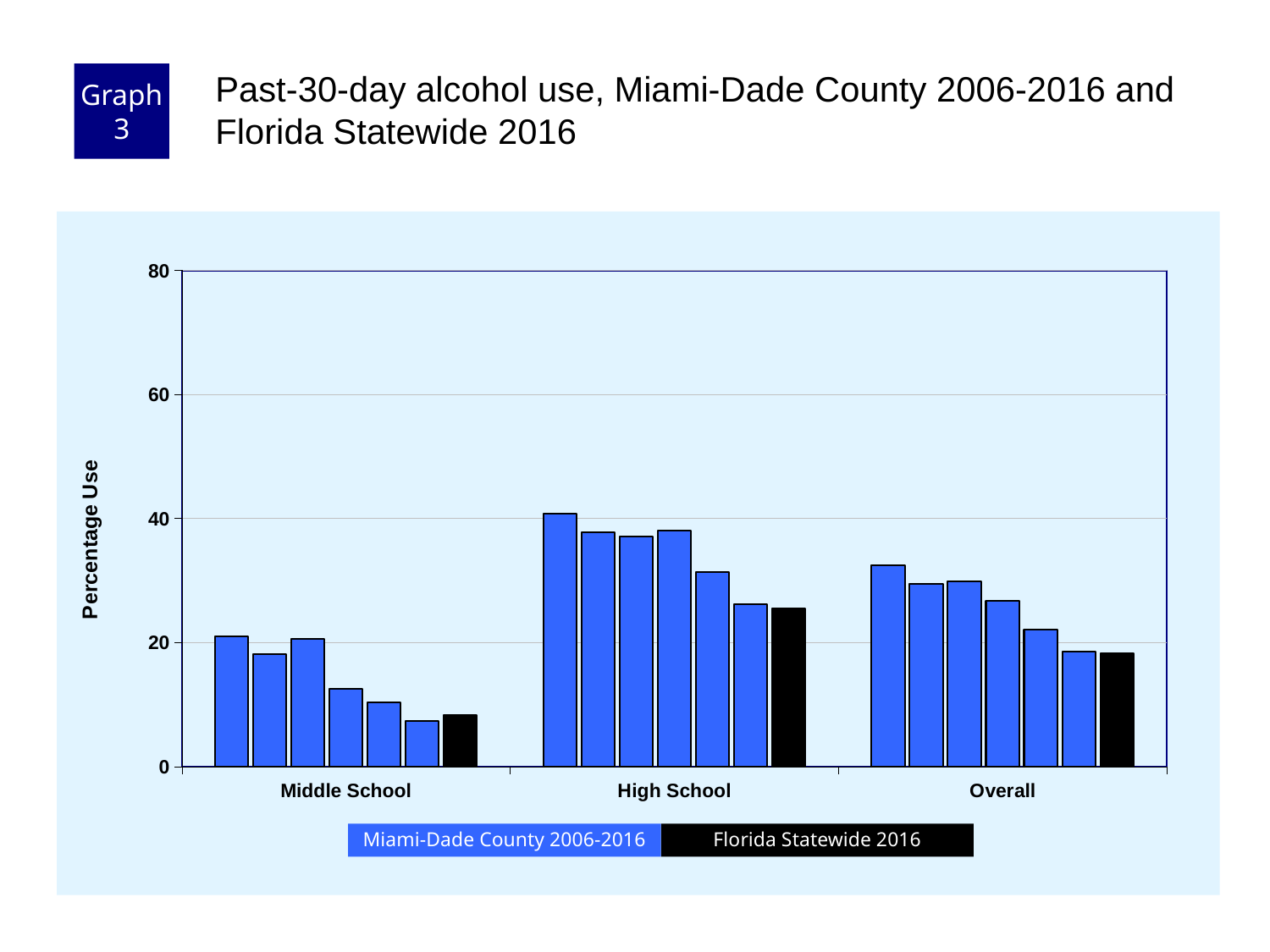
Within the High School group, do the Miami-Dade County bars generally rise or fall from 2006 to 2016? fall What kind of chart is shown on the slide? bar chart How many series does the legend list? 2 Which category has the highest bars overall? High School Is the Florida Statewide 2016 value for High School greater or less than 20? greater Which category has the lowest bars overall? Middle School Is the Florida Statewide 2016 value for Middle School greater or less than 20? less How many school-level categories are shown on the x axis? 3 Is the Florida Statewide 2016 value for Overall greater or less than 40? less Which colour represents Florida Statewide 2016 in the legend? black Is the Florida Statewide 2016 value for High School larger than the Florida Statewide 2016 value for Middle School? yes What is the label on the y axis? Percentage Use